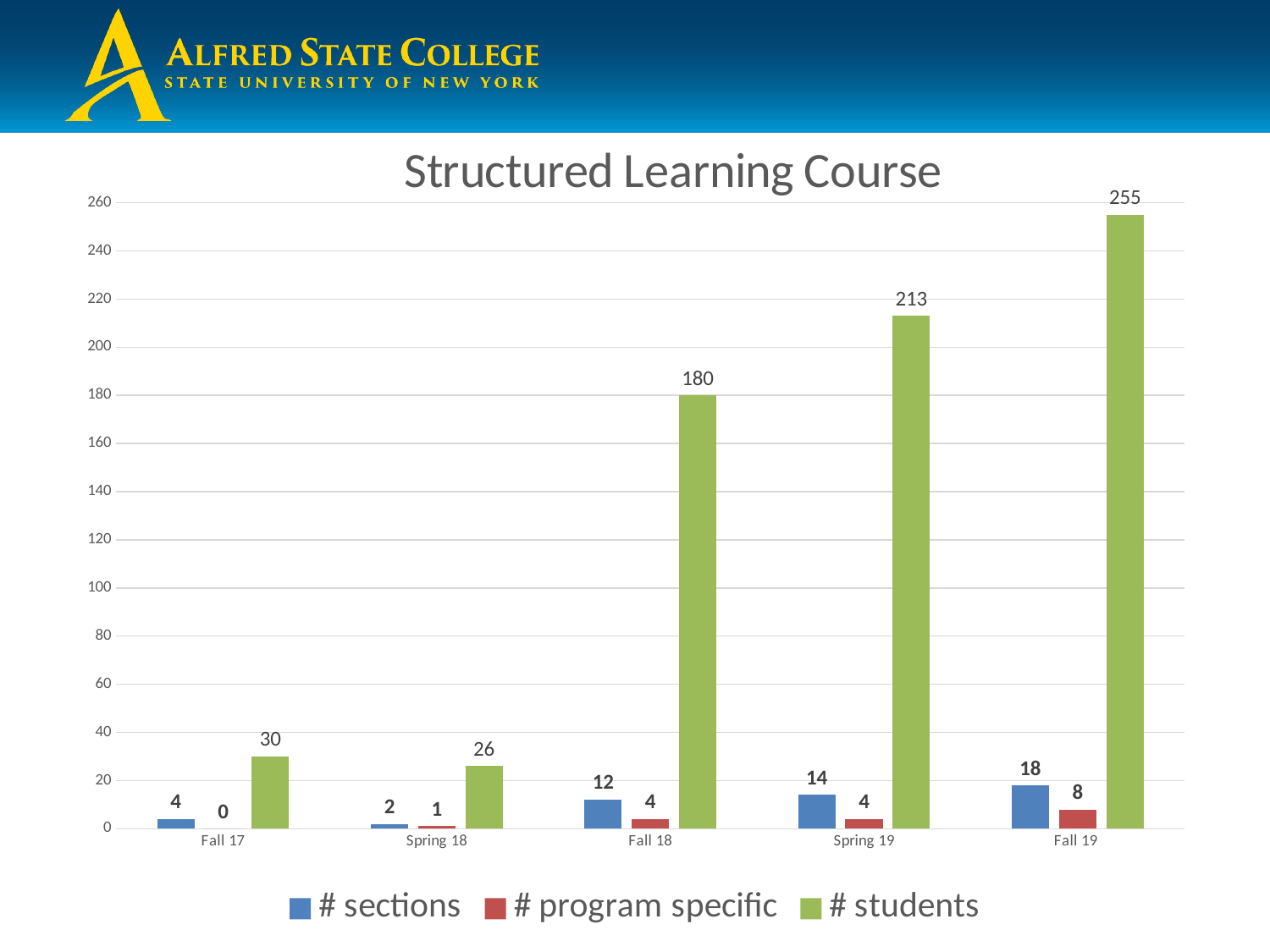
What is the number of students for Fall 19? 255 What is the number of sections for Spring 18? 2 How many semesters are shown on the x axis? 5 What kind of chart is shown on the slide? bar chart What is the difference in the number of students between Spring 19 and Fall 18? 33 Which semester has the lowest number of sections? Spring 18 What is the number of program specific for Fall 17? 0 Does the number of students rise or fall from Spring 18 to Fall 19? rise Which semester has the highest number of students? Fall 19 Which is larger, the number of students in Fall 17 or in Spring 18? Fall 17 Is the number of students for Spring 19 greater or less than 200? greater How many series does the legend list? 3